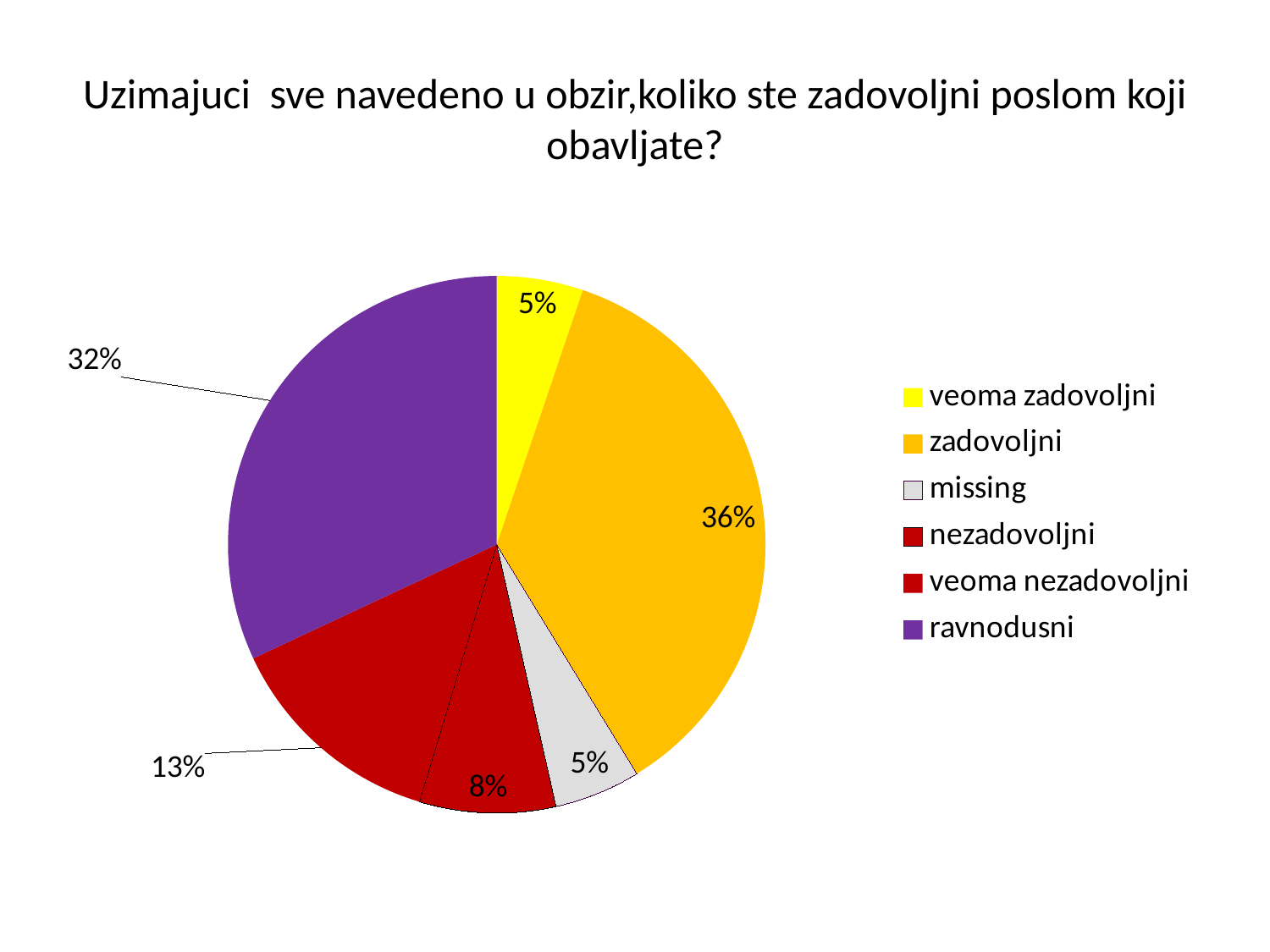
What share of the pie is labelled for veoma zadovoljni? 5% Which category has the largest slice of the pie? zadovoljni What share of the pie is labelled for ravnodusni? 32% What colour is the slice for ravnodusni? purple What share of the pie is labelled for zadovoljni? 36% What is the difference in percentage points between the zadovoljni slice and the ravnodusni slice? 4 What kind of chart is shown on the slide? pie chart How many categories does the legend list? 6 Which is larger, the slice for ravnodusni or the slice for veoma nezadovoljni? ravnodusni